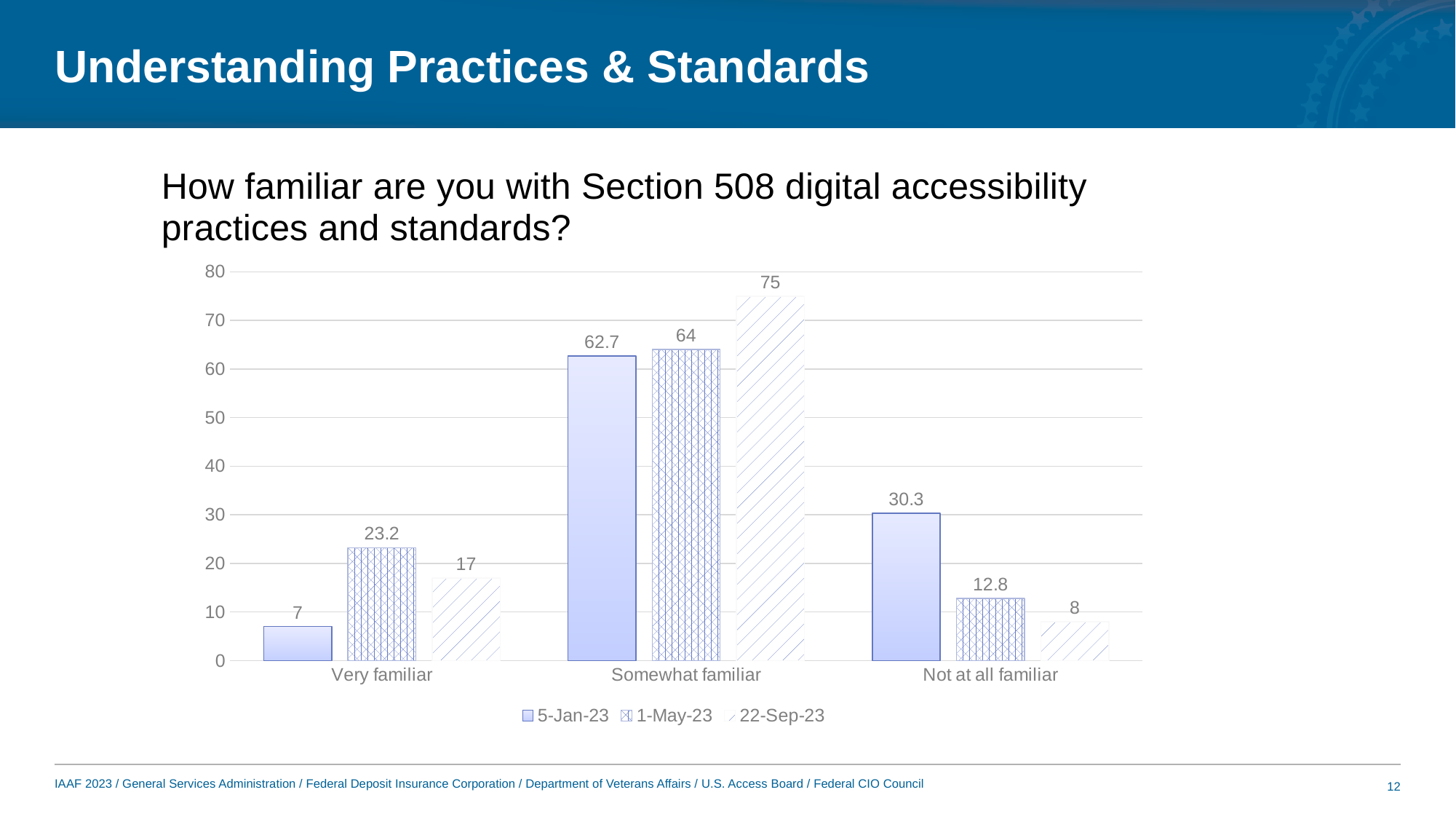
What kind of chart is shown on the slide? Bar chart Which category has the lowest value in the 22-Sep-23 series? Not at all familiar What is the value for Somewhat familiar in the 22-Sep-23 series? 75 What is the difference between the 22-Sep-23 and 5-Jan-23 values for Somewhat familiar? 12.3 Which is larger for Very familiar: the 1-May-23 value or the 22-Sep-23 value? 1-May-23 How many series does the legend list? 3 What is the value for Very familiar in the 5-Jan-23 series? 7 What is the value for Not at all familiar in the 1-May-23 series? 12.8 Is the value for Not at all familiar in the 5-Jan-23 series greater or less than 30? greater How many categories are shown on the x axis? 3 Does the value for Not at all familiar rise or fall from 5-Jan-23 to 22-Sep-23? Fall Which category has the highest value in the 5-Jan-23 series? Somewhat familiar